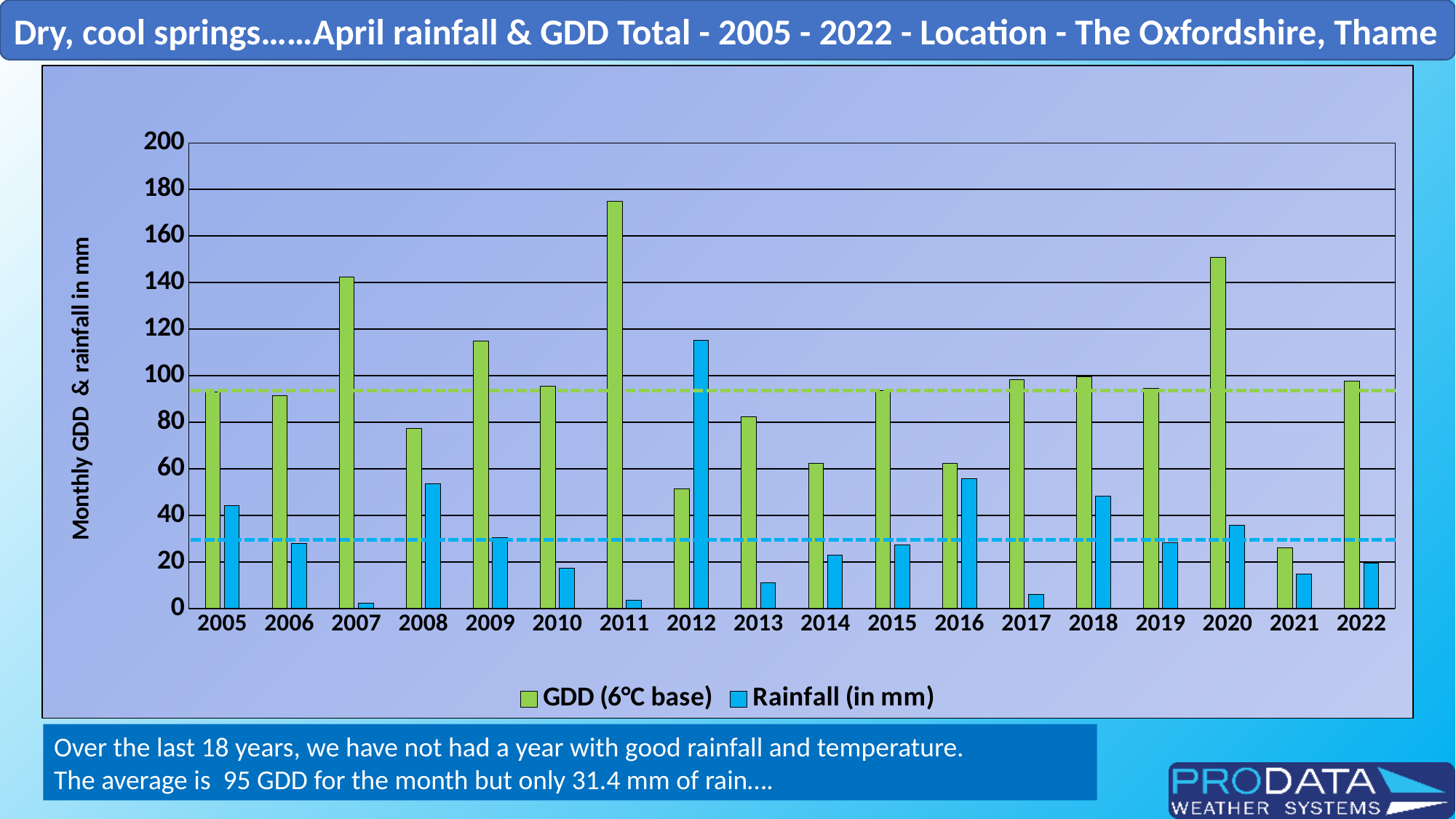
Is the GDD (6°C base) value for 2021 greater or less than 40? less Is the Rainfall (in mm) value for 2017 greater or less than 20? less How many years are shown on the x axis? 18 How many series does the legend list? 2 Is the GDD (6°C base) value for 2011 greater or less than 160? greater Which is larger, the Rainfall (in mm) value for 2016 or for 2010? 2016 Which year has the lowest GDD (6°C base) value? 2021 Which year has the highest Rainfall (in mm) value? 2012 What type of chart is shown on the slide? bar chart Which is larger, the GDD (6°C base) value for 2007 or for 2009? 2007 Which year has the highest GDD (6°C base) value? 2011